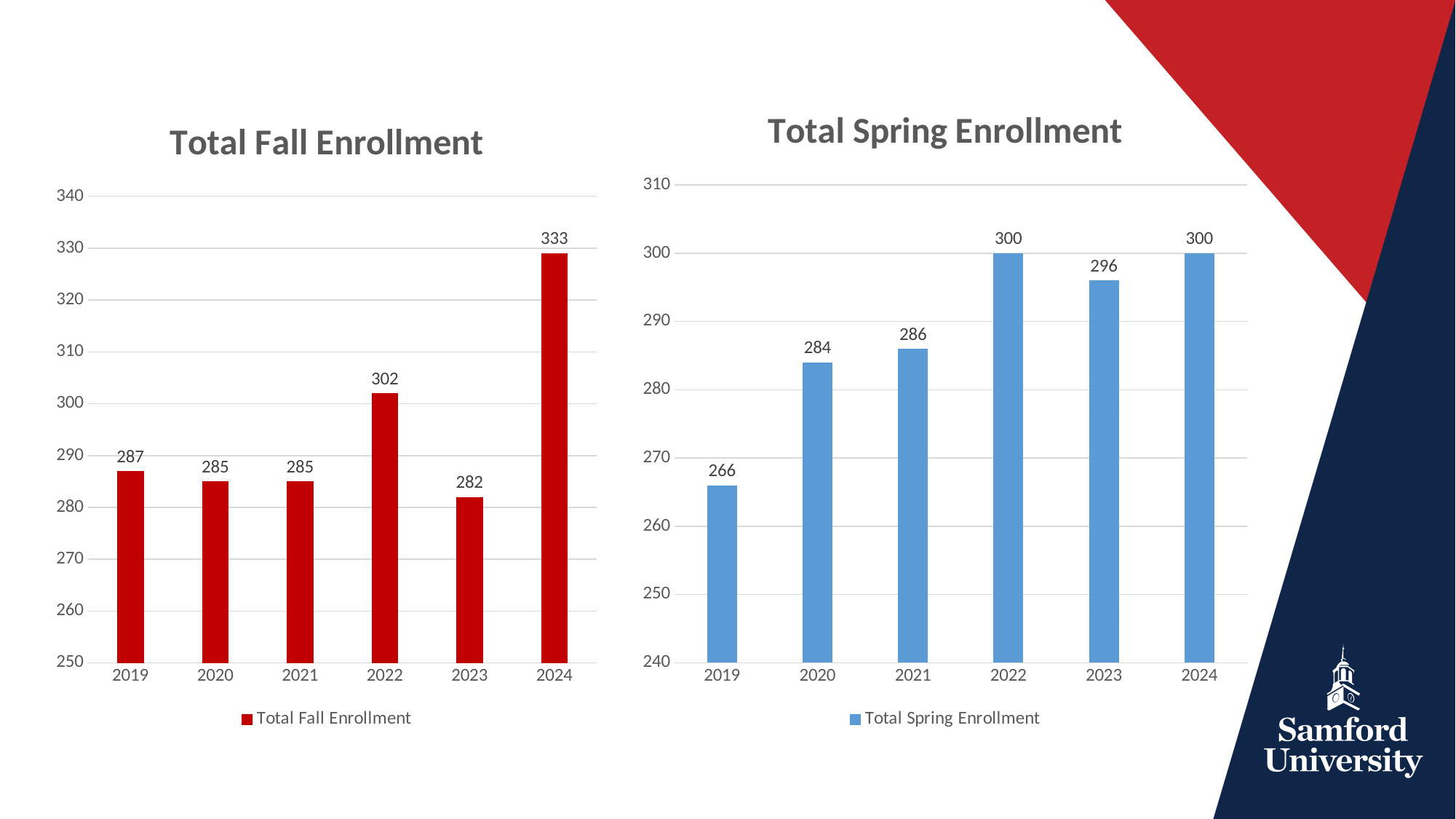
What kind of chart is the Total Spring Enrollment chart? bar chart In the Total Spring Enrollment chart, is the value for 2023 larger or smaller than the value for 2021? larger In the Total Spring Enrollment chart, what is the difference between the 2022 and 2019 values? 34 How many years are shown on the x axis of the Total Fall Enrollment chart? 6 In the Total Spring Enrollment chart, do the values generally rise or fall from 2019 to 2022? rise In the Total Spring Enrollment chart, which year has the lowest enrollment? 2019 What colour are the bars in the Total Fall Enrollment chart? red In the Total Fall Enrollment chart, what is the value for 2024? 333 In the Total Fall Enrollment chart, which year has the lowest enrollment? 2023 In the Total Fall Enrollment chart, which year has the highest enrollment? 2024 In the Total Spring Enrollment chart, what is the value for 2019? 266 In the Total Fall Enrollment chart, what is the difference between the 2024 and 2023 values? 51